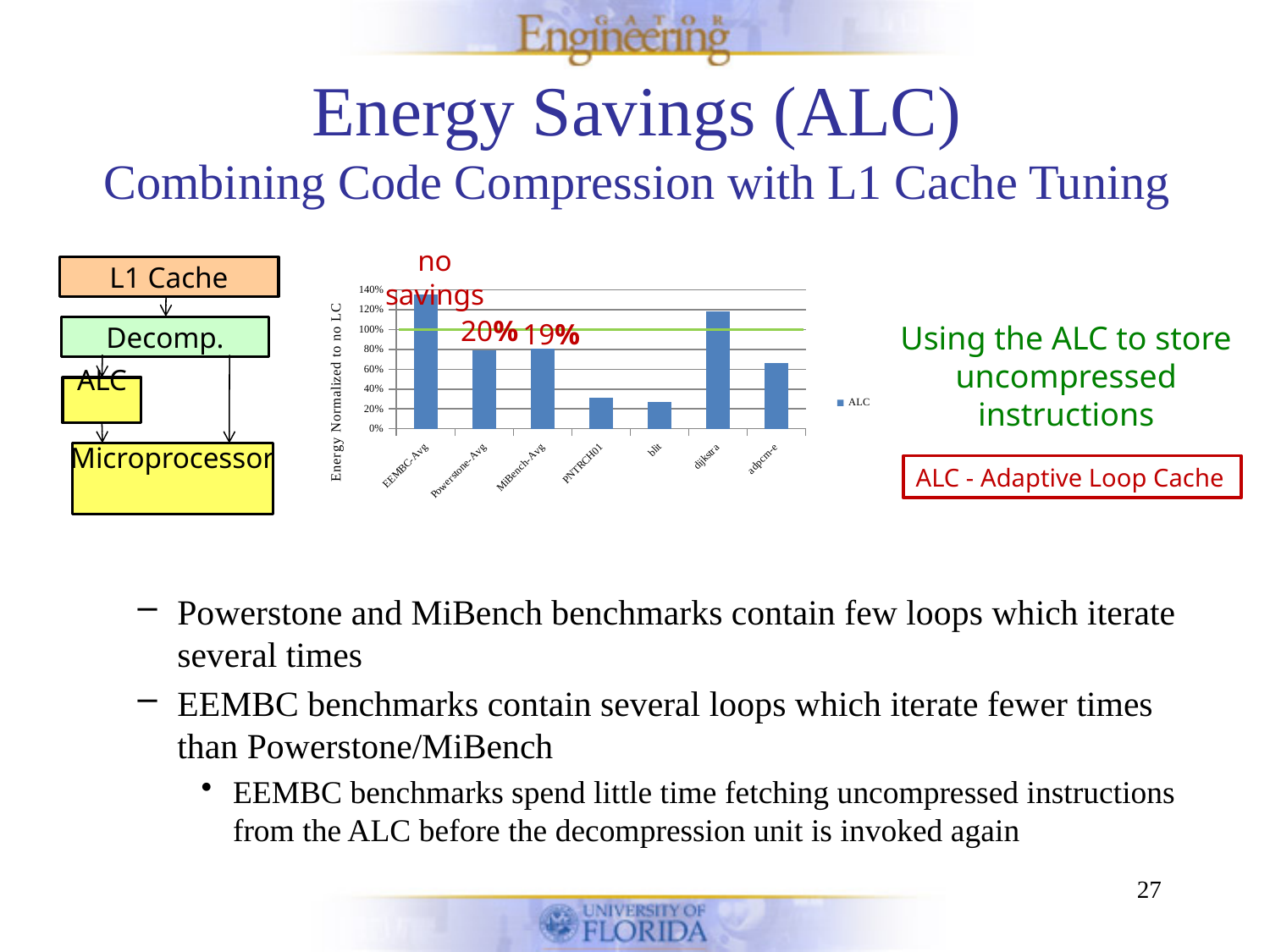
What kind of chart is shown on the slide? bar chart What series name appears in the chart legend? ALC Is the value for dijkstra greater or less than 100%? greater What is the title of the chart's y axis? Energy Normalized to no LC Which has the larger value, dijkstra or adpcm-e? dijkstra Is the value for EEMBC-Avg greater or less than 100%? greater Which category has the lowest bar in the chart? blit How many categories are plotted along the x axis of the chart? 7 How many series does the chart legend list? 1 Is the value for adpcm-e greater or less than 80%? less Which category has the highest bar in the chart? EEMBC-Avg